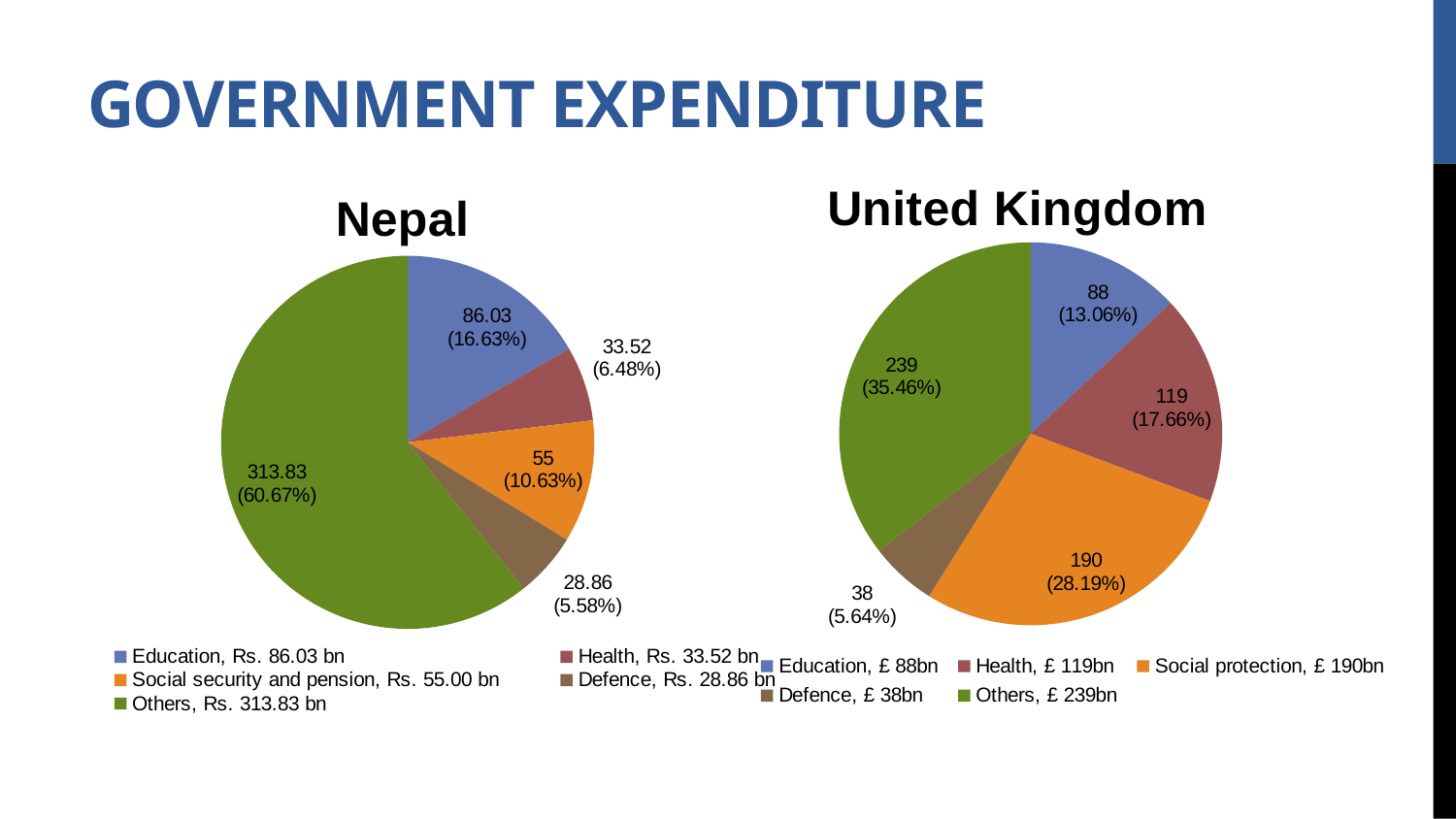
In the United Kingdom chart, what colour is the Defence slice? Brown In the Nepal chart, what is the value for Education? 86.03 In the Nepal chart, what share of the pie does Others take? 60.67% In the United Kingdom chart, what is the difference between Others and Defence? 201 In the United Kingdom chart, which category is the largest? Others In the Nepal chart, what is the difference between Social security and pension and Health? 21.48 What kind of charts are shown on the slide? Pie charts In the Nepal chart, which category is the smallest? Defence In the United Kingdom chart, what is the value for Social protection? 190 How many slices does the Nepal pie chart have? 5 In the United Kingdom chart, what share of the pie does Health take? 17.66% In the United Kingdom chart, which is larger, Education or Health? Health